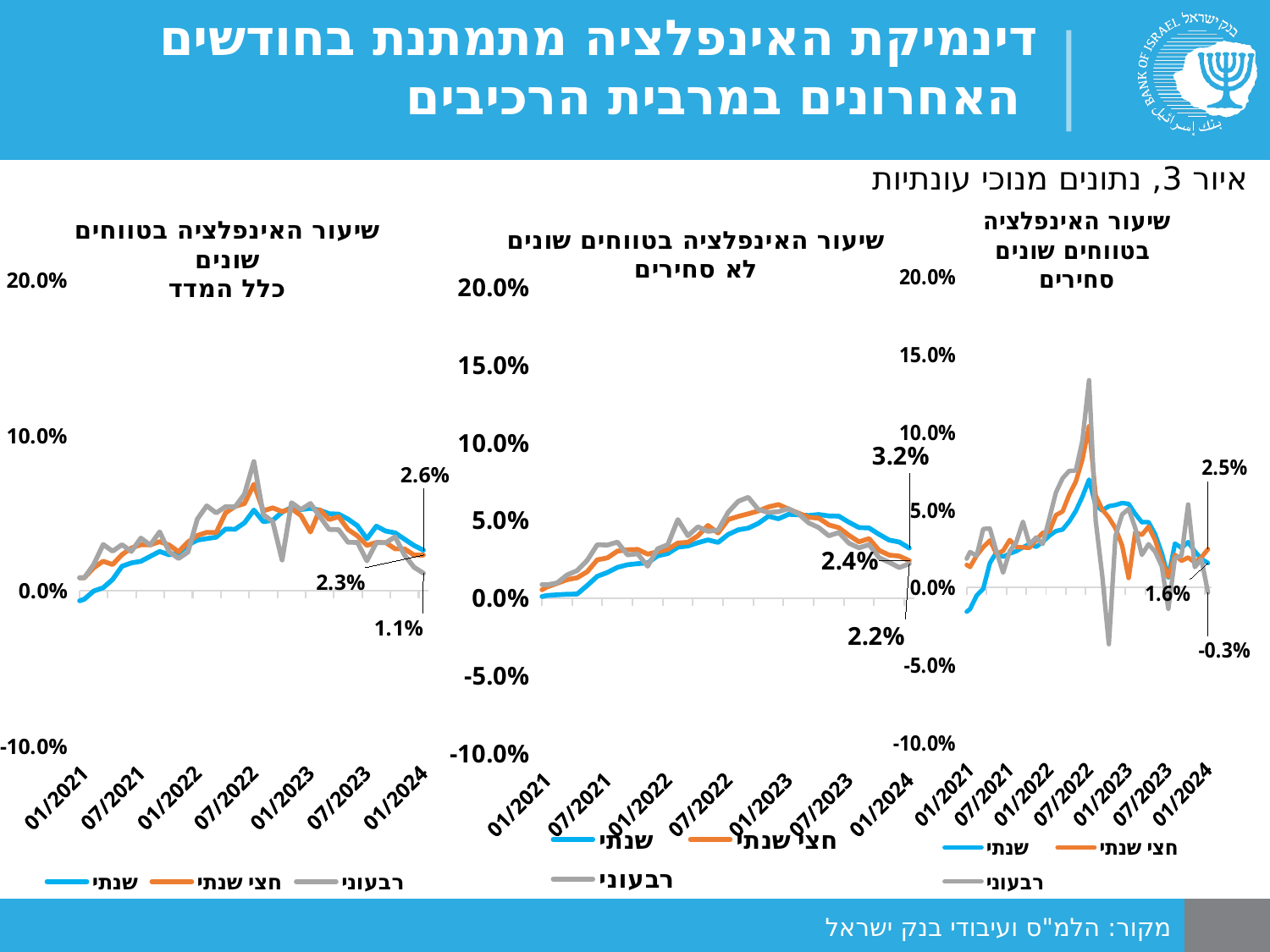
How many series does the legend of the middle chart ('לא סחירים') list? 3 In the left chart ('כלל המדד'), what is the final labelled value of the quarterly (רבעוני) series? 1.1% In the right chart ('סחירים'), what is the final labelled value of the semi-annual (חצי שנתי) series? 2.5% In the right chart ('סחירים'), is the peak of the quarterly (רבעוני) series in 2022 greater or less than 10.0%? greater In the left chart ('כלל המדד'), what is the final labelled value of the annual (שנתי) series? 2.6% In the middle chart ('לא סחירים'), does the annual (שנתי) series rise or fall from 01/2021 to 01/2023? rise In the middle chart ('לא סחירים'), what is the difference between the final annual value (3.2%) and the final quarterly value (2.2%)? 1.0% In the right chart ('סחירים'), what is the final labelled value of the quarterly (רבעוני) series? -0.3% In the right chart ('סחירים'), which series has the highest final labelled value? חצי שנתי What kind of chart is the left chart titled 'שיעור האינפלציה בטווחים שונים כלל המדד'? line chart In the left chart ('כלל המדד'), which is larger at the end: the annual (שנתי) value or the semi-annual (חצי שנתי) value? שנתי (2.6%) In the middle chart ('לא סחירים'), what is the final labelled value of the annual (שנתי) series? 3.2%